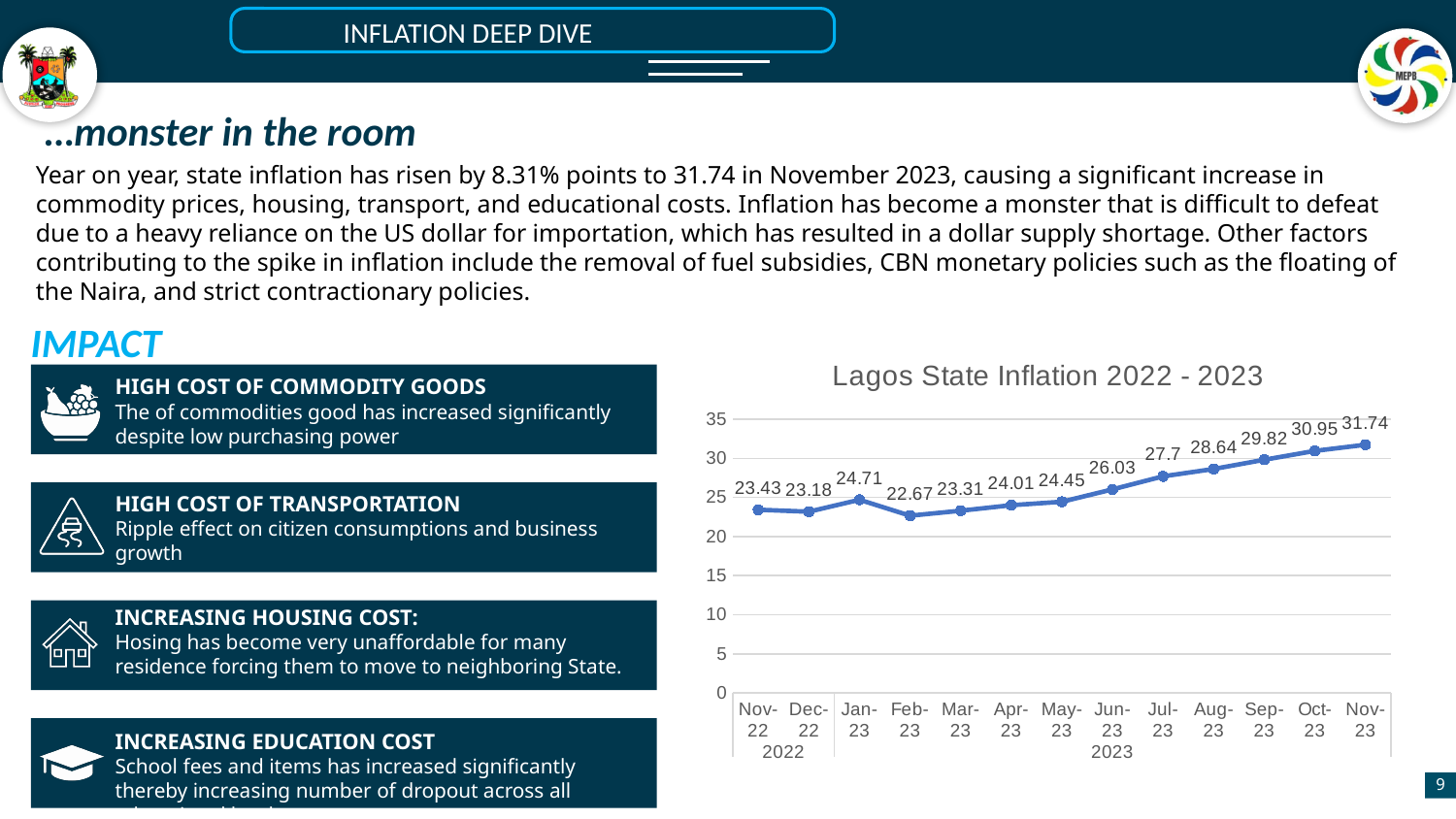
What is the inflation value for Nov-23 in the Lagos State Inflation 2022 - 2023 chart? 31.74 Which month has the lowest inflation value in the chart? Feb-23 What is the inflation value for Feb-23? 22.67 How many data points are plotted in the Lagos State Inflation 2022 - 2023 chart? 13 What kind of chart is used to show Lagos State Inflation 2022 - 2023? Line chart What is the inflation value for Nov-22? 23.43 Which is larger, the inflation value for Jan-23 or for Dec-22? Jan-23 What is the difference between the inflation values for Nov-23 and Nov-22? 8.31 Which month has the highest inflation value in the chart? Nov-23 Is the inflation value for Jun-23 greater or less than 25? greater Do the inflation values generally rise or fall from Feb-23 to Nov-23? Rise What is the inflation value for Jul-23? 27.7